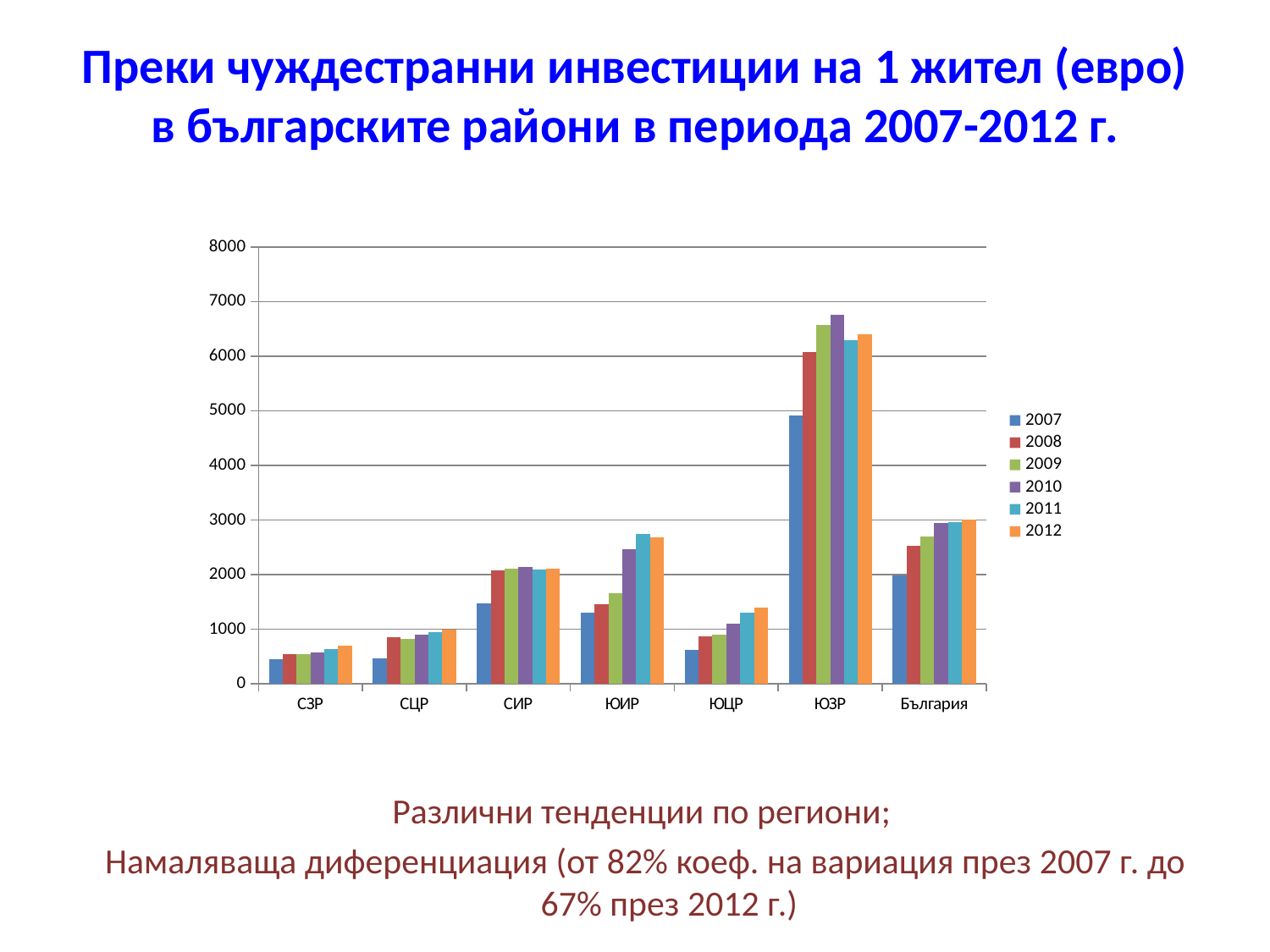
Is the value for ЮЗР in 2010 greater or less than 6000? greater Which region has the highest values in the chart? ЮЗР For ЮЗР, which year has the highest bar? 2010 Which years are listed in the chart legend? 2007, 2008, 2009, 2010, 2011, 2012 Is the value for СЗР in 2012 greater or less than 1000? less How many regions (categories) are shown on the x axis of the chart? 7 Do the values for България rise or fall from 2007 to 2012? rise How many series does the legend list? 6 Which is larger in 2012: the value for ЮИР or the value for ЮЦР? ЮИР What kind of chart is shown on the slide? bar chart Is the value for ЮИР in 2011 greater or less than 2000? greater